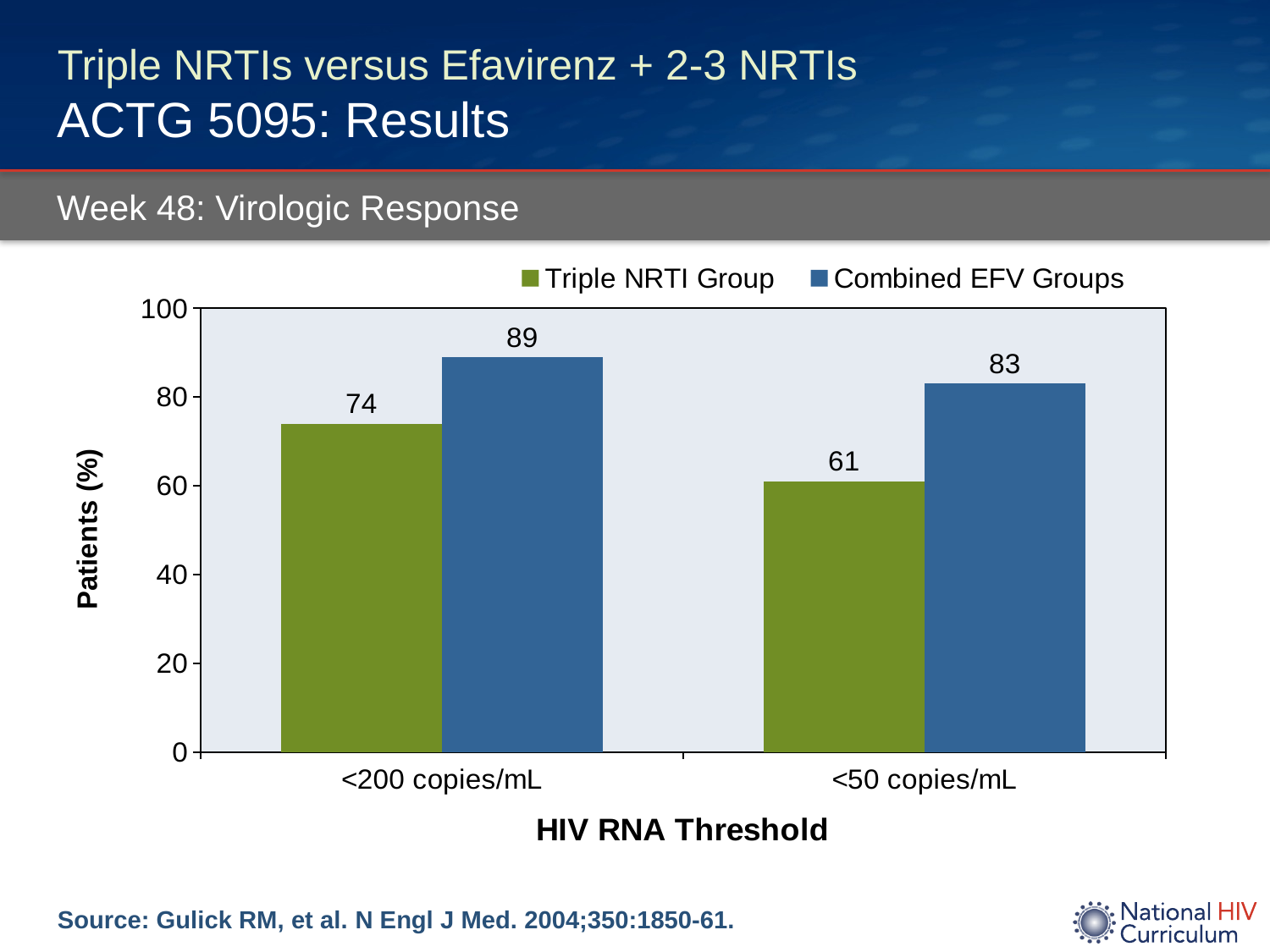
What is the value for the Triple NRTI Group at the <50 copies/mL threshold? 61 What is the label of the y axis? Patients (%) Which bar has the lowest value on the chart? Triple NRTI Group at <50 copies/mL How many HIV RNA threshold categories are shown on the x axis? 2 What is the value for the Combined EFV Groups at the <50 copies/mL threshold? 83 What is the value for the Triple NRTI Group at the <200 copies/mL threshold? 74 What is the difference between the Combined EFV Groups and the Triple NRTI Group at the <50 copies/mL threshold? 22 How many series does the legend list? 2 Which is larger at the <200 copies/mL threshold: the Triple NRTI Group or the Combined EFV Groups? Combined EFV Groups What kind of chart is shown on the slide? Bar chart Which bar has the highest value on the chart? Combined EFV Groups at <200 copies/mL What is the value for the Combined EFV Groups at the <200 copies/mL threshold? 89